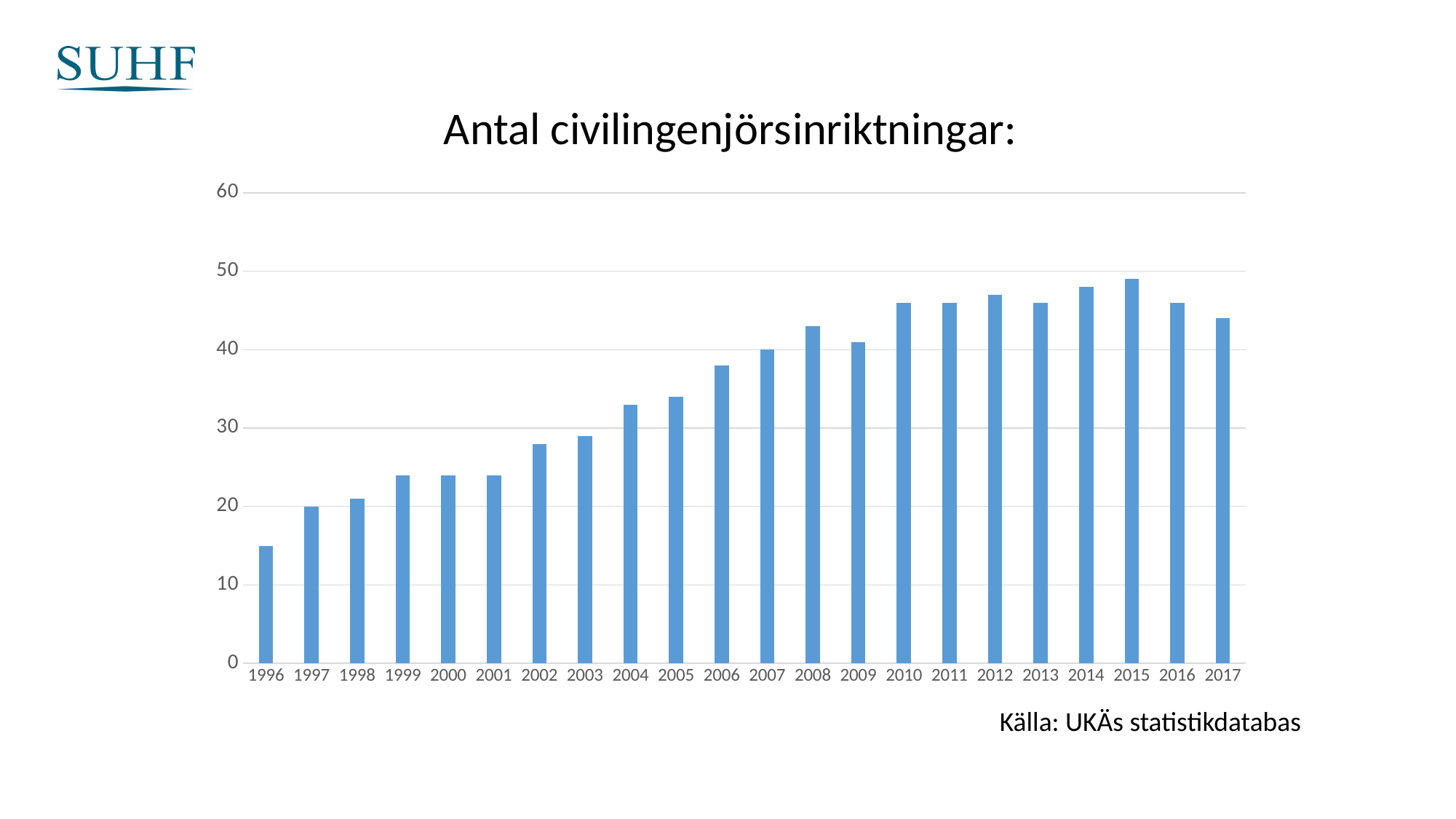
Is the value for 2002 greater or less than 30? less Which year has the larger value, 2005 or 2006? 2006 Which year has the lowest value in the chart? 1996 Is the value for 2004 greater or less than 30? greater What kind of chart is shown on the slide? bar chart Which year has the highest value in the chart? 2015 Is the value for 2006 greater or less than 40? less What is the title of the chart? Antal civilingenjörsinriktningar: Do the values generally rise or fall from 1996 to 2015? rise How many years are shown on the x axis of the chart? 22